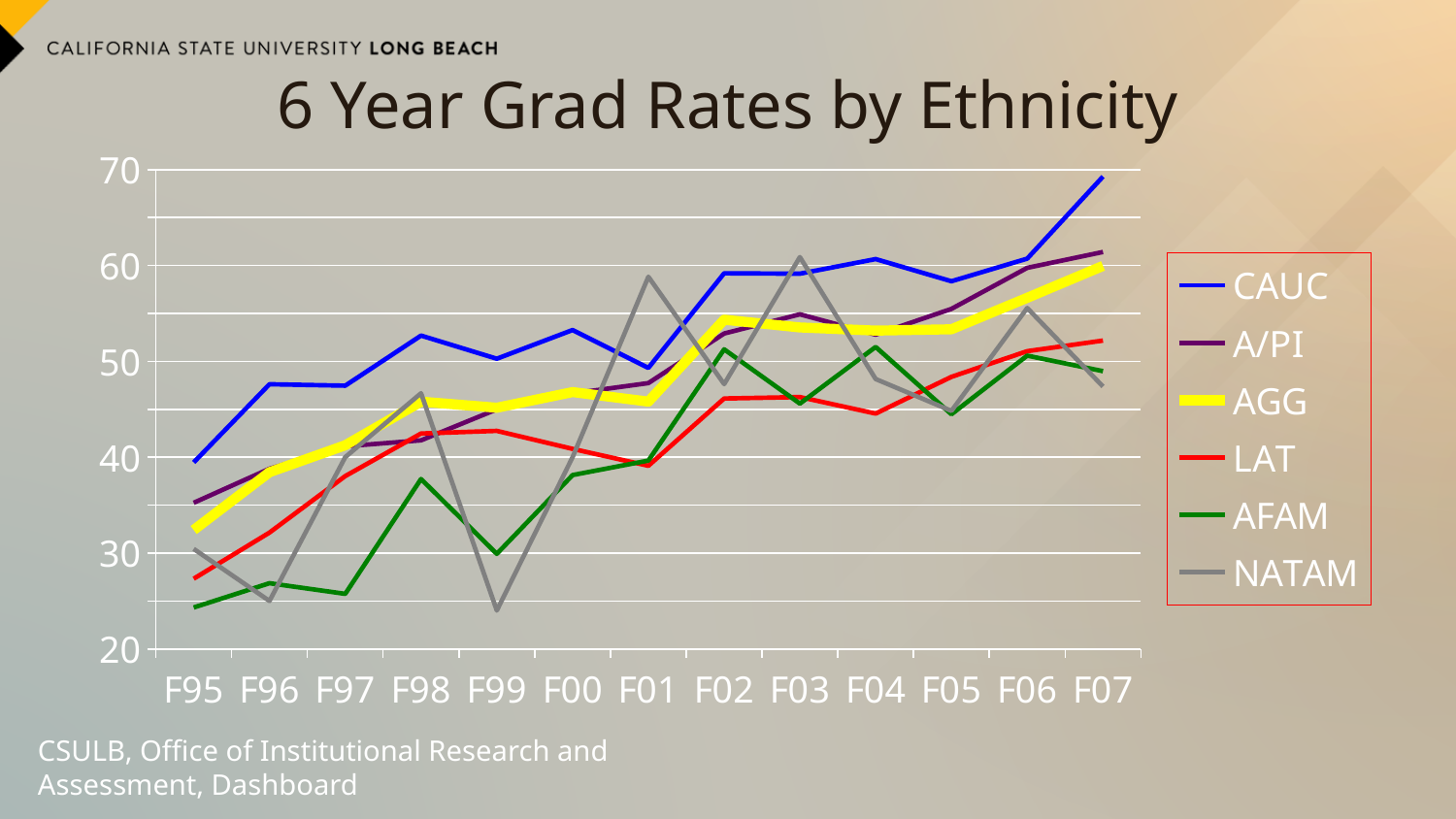
Which series is drawn with the thick yellow line? AGG What is the title of the chart? 6 Year Grad Rates by Ethnicity Which series has the highest value at F01? NATAM How many series does the legend list? 6 Does the CAUC series generally rise or fall from F95 to F07? rise Which series has the highest value at F07? CAUC Which series has the lowest value at F95? AFAM What kind of chart is shown on the slide? line chart Is the value for NATAM at F99 greater or less than 30? less Is the value for CAUC at F07 greater or less than 60? greater At F07, which is larger, the value for CAUC or the value for LAT? CAUC How many cohort years are shown along the x axis? 13